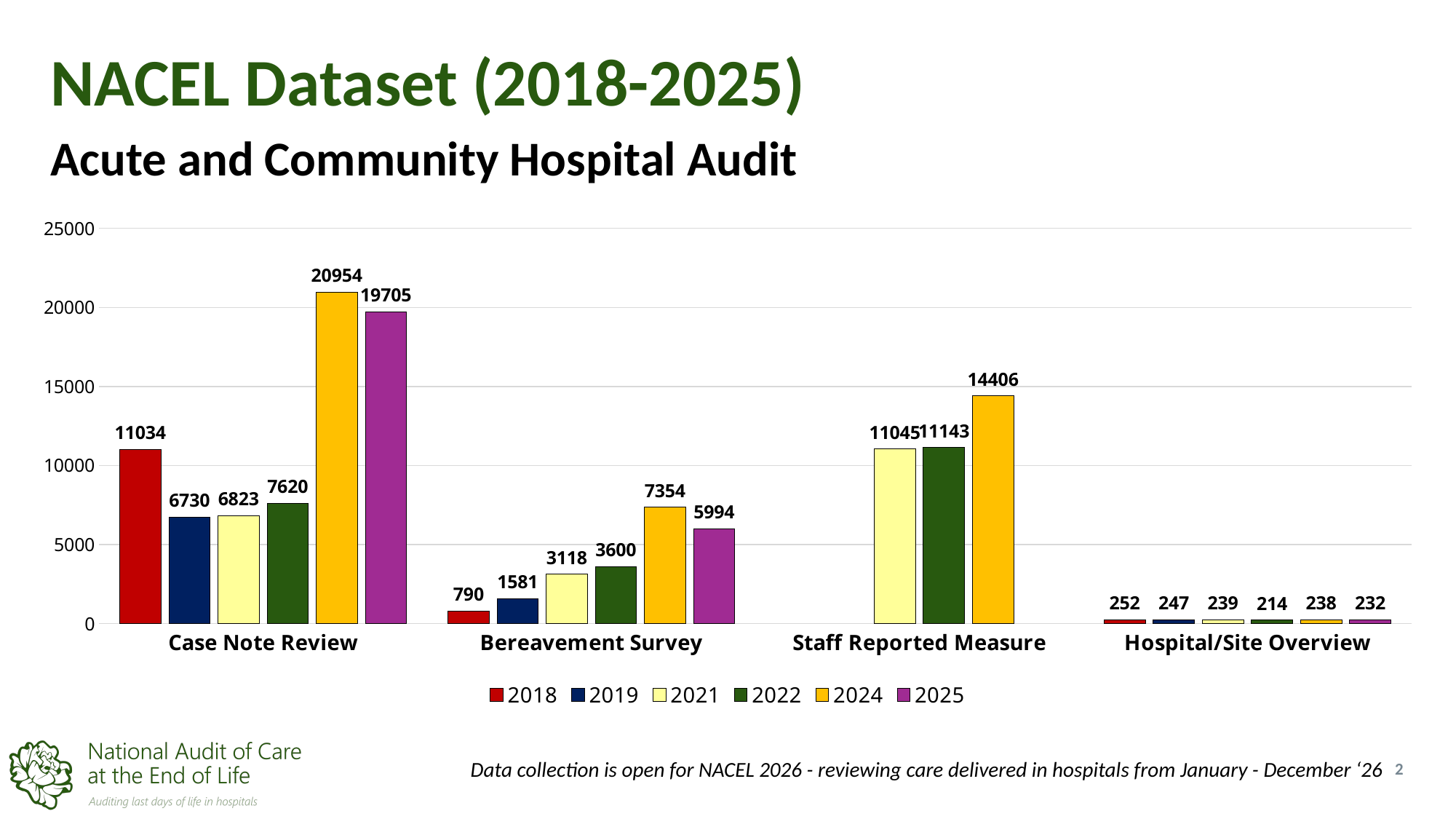
What is the difference between the 2018 and 2025 values for Hospital/Site Overview? 20 Which year has the lowest value for Hospital/Site Overview? 2022 What is the value for Case Note Review in 2024? 20954 Is the value for Staff Reported Measure in 2024 greater or less than 15000? less How many series does the legend list? 6 For Bereavement Survey, which year has the larger value, 2024 or 2025? 2024 What kind of chart is shown on the slide? bar chart What is the difference between the 2024 and 2025 values for Case Note Review? 1249 Which year has the highest value for Case Note Review? 2024 What is the value for Bereavement Survey in 2018? 790 What is the value for Staff Reported Measure in 2022? 11143 How many categories are shown on the x axis? 4